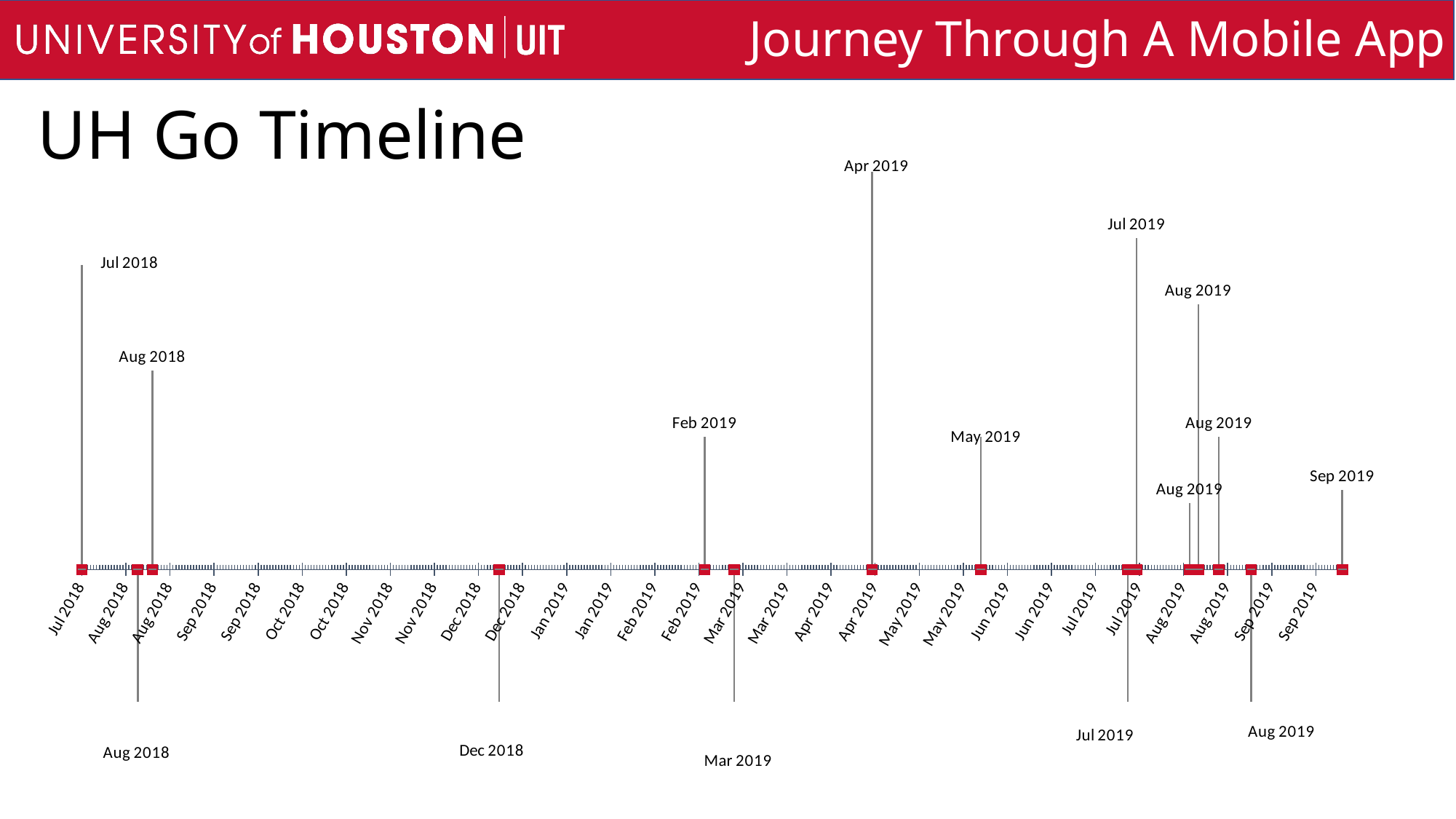
How many milestones on the timeline are labeled Aug 2018? 2 What kind of chart is shown on the slide? Timeline chart How many milestone markers are plotted on the timeline? 15 How many milestone labels are placed below the timeline axis? 5 What is the latest milestone date shown on the timeline? Sep 2019 What is the earliest milestone date shown on the timeline? Jul 2018 Is there a milestone on the timeline labeled Oct 2018? No What is the title of the chart on the slide? UH Go Timeline Which comes first on the timeline, the Dec 2018 milestone or the Feb 2019 milestone? Dec 2018 Which milestone label has the tallest connector line above the timeline axis? Apr 2019